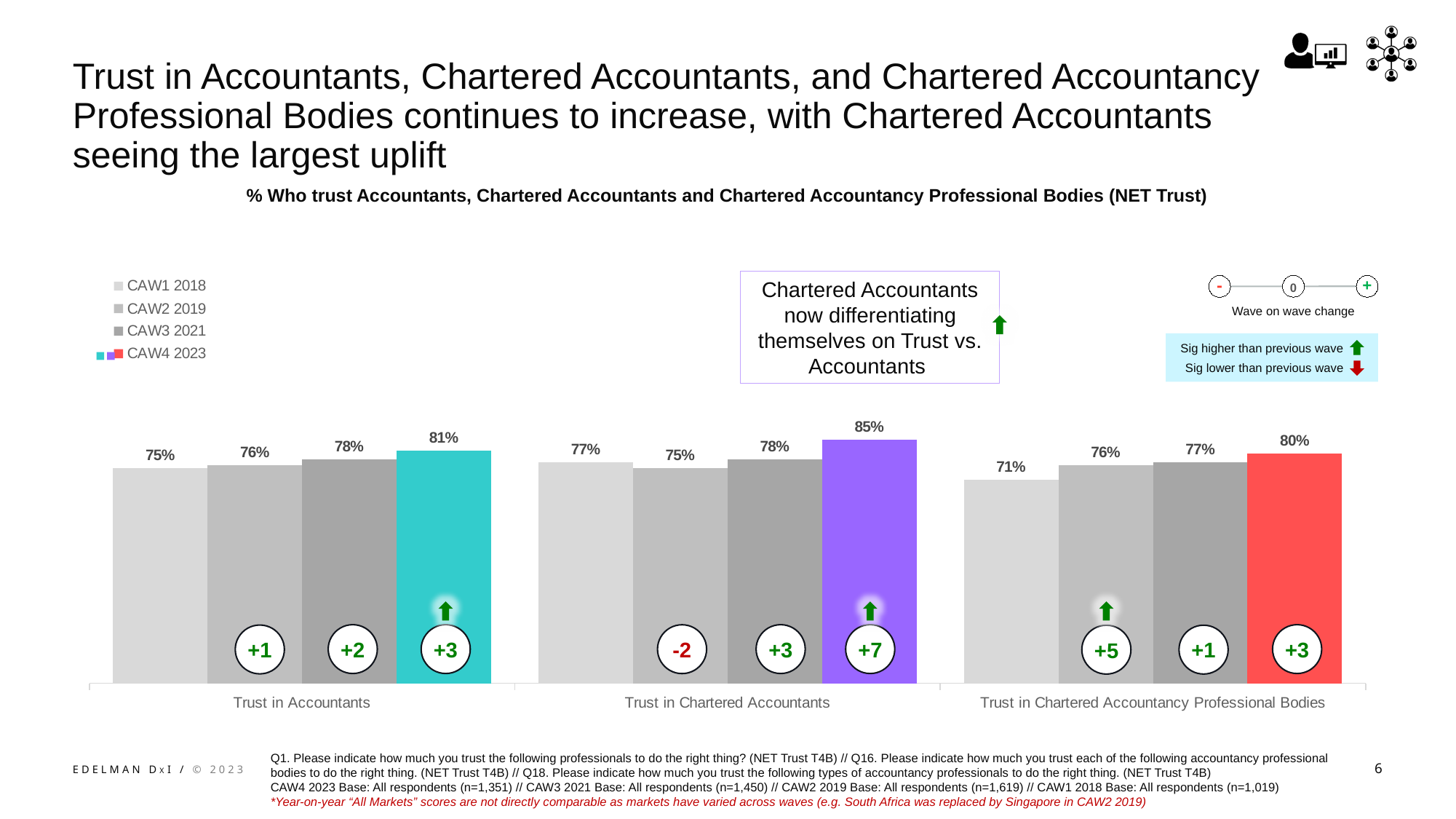
What is the CAW2 2019 value for Trust in Accountants? 76% Which category has the highest CAW4 2023 value? Trust in Chartered Accountants Which category has the lowest CAW1 2018 value? Trust in Chartered Accountancy Professional Bodies What is the difference between the CAW4 2023 and CAW3 2021 values for Trust in Chartered Accountants? 7 percentage points What kind of chart is shown on the slide? Bar chart How many categories are shown on the x axis? 3 How many series does the legend list? 4 What is the CAW1 2018 value for Trust in Chartered Accountancy Professional Bodies? 71% What is the CAW3 2021 value for Trust in Chartered Accountants? 78% Do the values for Trust in Accountants rise or fall from CAW1 2018 to CAW4 2023? Rise What is the CAW4 2023 value for Trust in Chartered Accountants? 85% Which is larger: the CAW2 2019 value for Trust in Accountants or the CAW2 2019 value for Trust in Chartered Accountants? Trust in Accountants